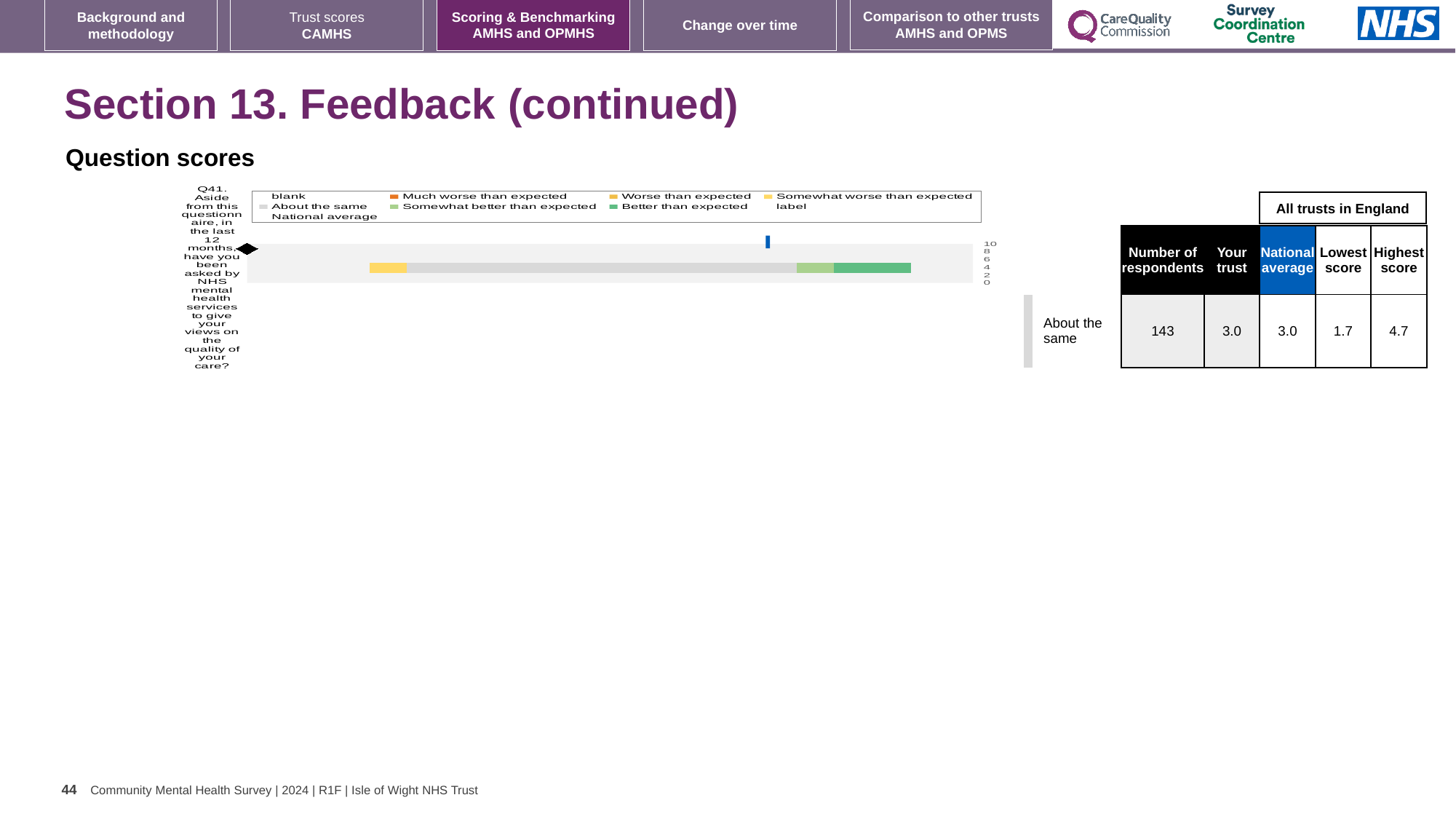
How is the trust's score for Q41 categorised relative to expectation on this slide? About the same What is the national average score for Q41? 3.0 What is the highest score among all trusts in England for Q41? 4.7 What is the lowest score among all trusts in England for Q41? 1.7 How many questions (categories) are plotted in the chart on this slide? 1 Is the 'Your trust' score for Q41 larger than, smaller than, or equal to the national average? equal What is the difference between the highest score and the lowest score for Q41? 3.0 What is the 'Your trust' score for Q41? 3.0 In the chart legend, which colour represents 'Much worse than expected'? orange What kind of chart is shown for Q41 on this slide? bar chart Which question number is plotted in the chart on this slide? Q41 What is the number of respondents for Q41? 143